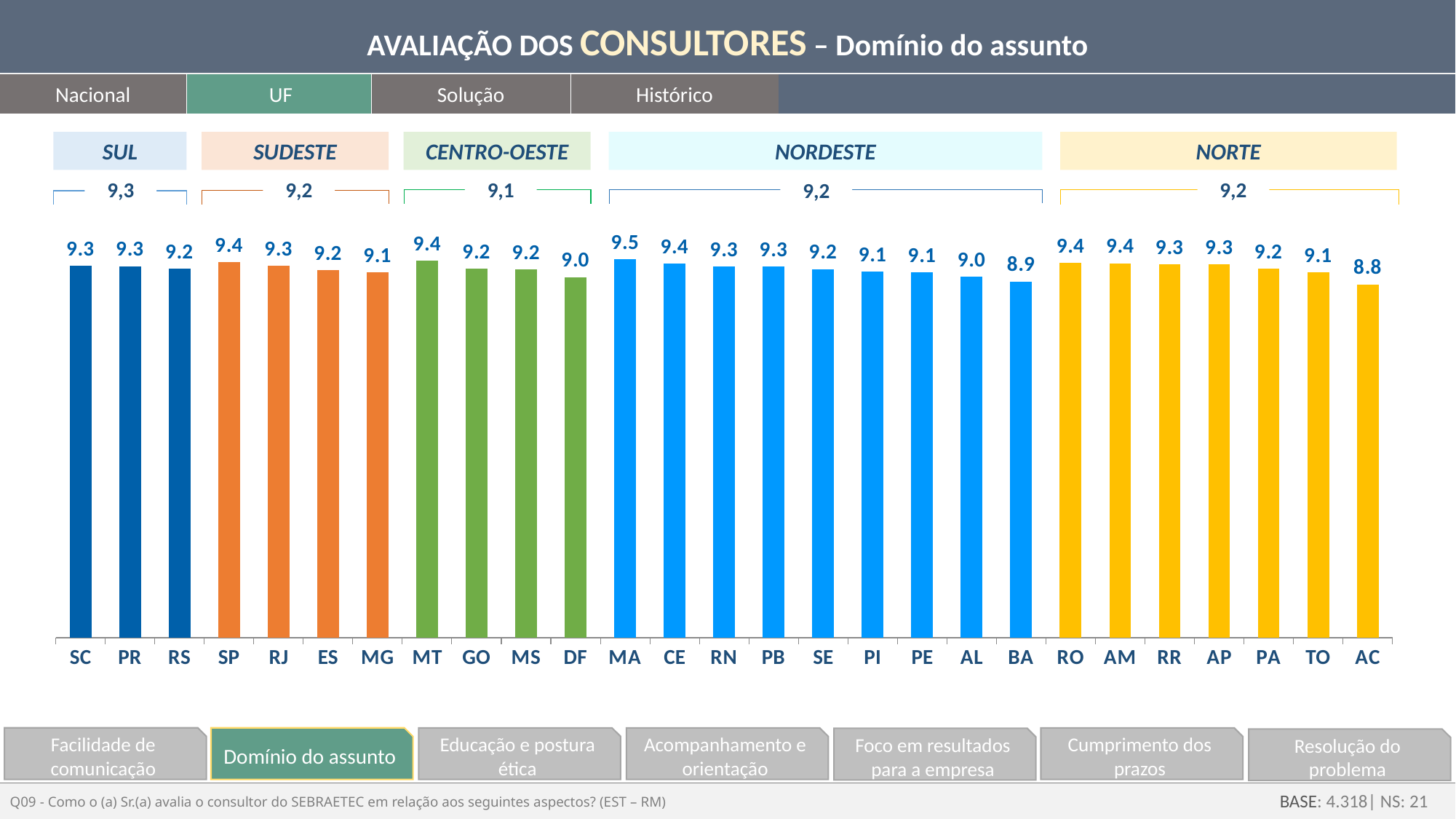
Which state has the highest value? MA What is the regional average shown for SUL? 9,3 What is the value for DF? 9.0 Which state has the lowest value? AC What is the difference between the values for MA and AC? 0.7 Which is larger, the value for BA or the value for RO? RO What is the value for AC? 8.8 What is the value for SP? 9.4 What is the value for MA? 9.5 What kind of chart is shown? Bar chart What is the regional average shown for CENTRO-OESTE? 9,1 How many states are shown on the x axis? 27